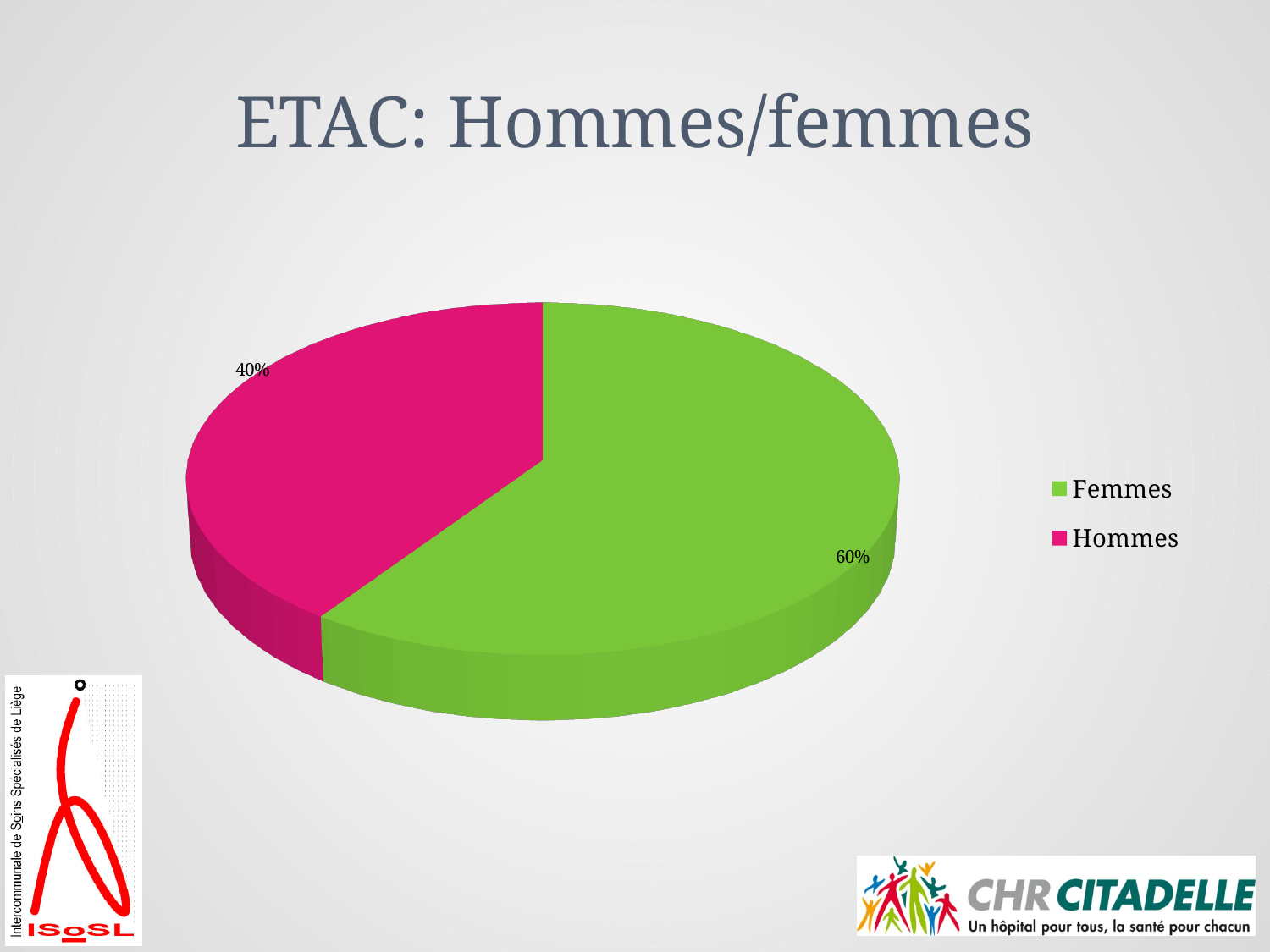
What colour is the Hommes slice? Pink Which category has the smallest slice of the pie? Hommes What share of the pie is Hommes? 40% What kind of chart is shown on the slide? Pie chart Which category has the largest slice of the pie? Femmes How many entries does the legend list? 2 What is the title of the slide? ETAC: Hommes/femmes How many slices does the pie chart have? 2 What is the difference in percentage points between the Femmes and Hommes slices? 20 percentage points Which slice is larger, Femmes or Hommes? Femmes What share of the pie is Femmes? 60%